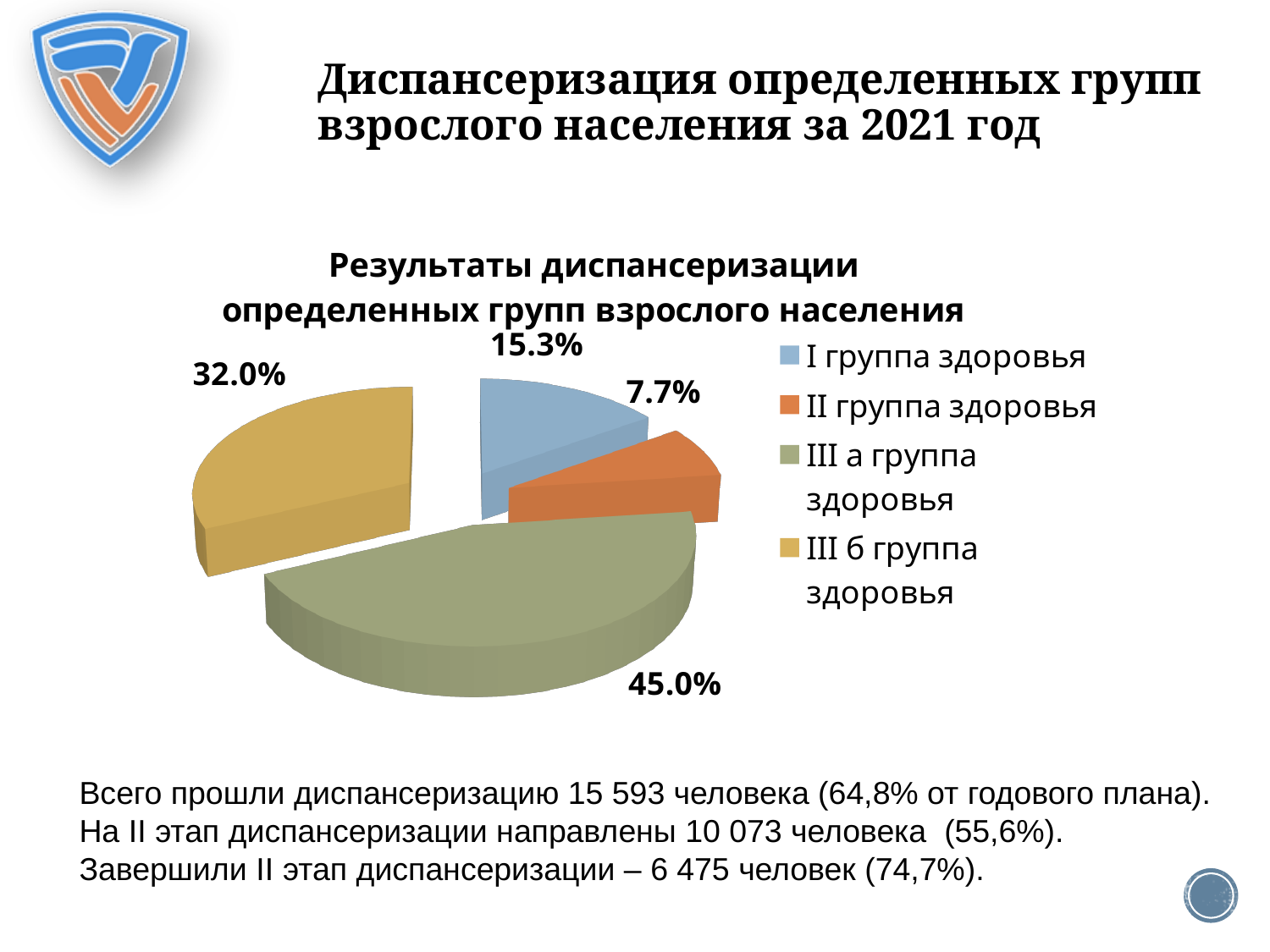
How many categories does the legend list? 4 What is the value for III б группа здоровья? 32.0% What is the title of the chart? Результаты диспансеризации определенных групп взрослого населения Which health group has the largest share of the pie? III а группа здоровья What is the value for I группа здоровья? 15.3% Which health group has the smallest share of the pie? II группа здоровья Which is larger: the share of I группа здоровья or II группа здоровья? I группа здоровья What is the difference between the shares of I группа здоровья and II группа здоровья? 7.6% What kind of chart is shown on the slide? Pie chart What is the value for III а группа здоровья? 45.0% What is the value for II группа здоровья? 7.7% What is the difference between the shares of III а группа здоровья and III б группа здоровья? 13.0%